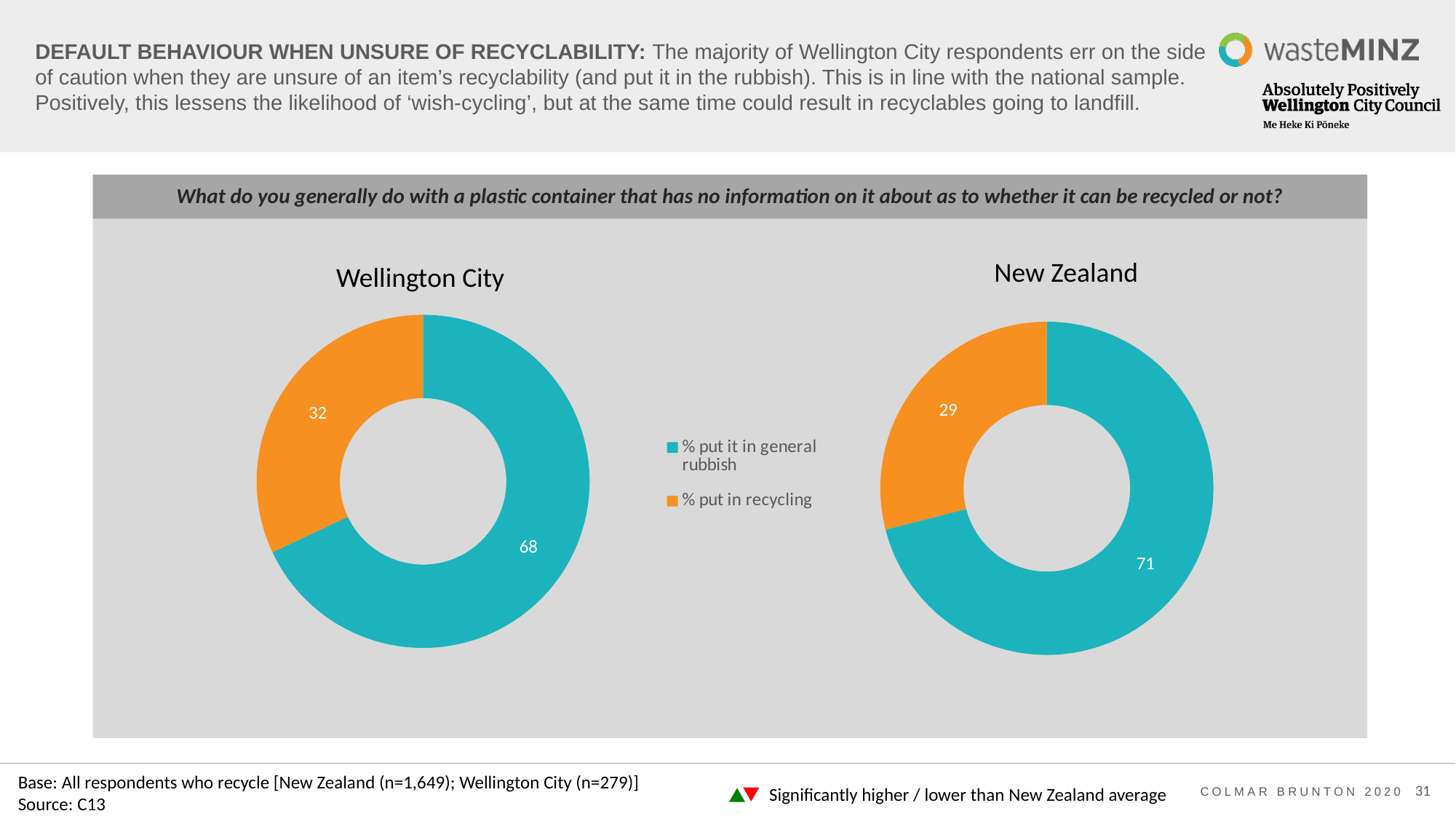
In the Wellington City chart, what is the difference between '% put it in general rubbish' and '% put in recycling'? 36 How many slices does the New Zealand chart have? 2 In the Wellington City chart, what is the value for '% put in recycling'? 32 In the New Zealand chart, what is the value for '% put it in general rubbish'? 71 In the Wellington City chart, what is the value for '% put it in general rubbish'? 68 In the New Zealand chart, what is the value for '% put in recycling'? 29 In the New Zealand chart, which category has the smallest share? % put in recycling Is the '% put it in general rubbish' value larger in the Wellington City chart or the New Zealand chart? New Zealand What kind of chart is the Wellington City chart? Pie chart (doughnut) How many series does the legend list? 2 What colour represents '% put in recycling' in the charts? Orange In the Wellington City chart, which category has the largest share? % put it in general rubbish